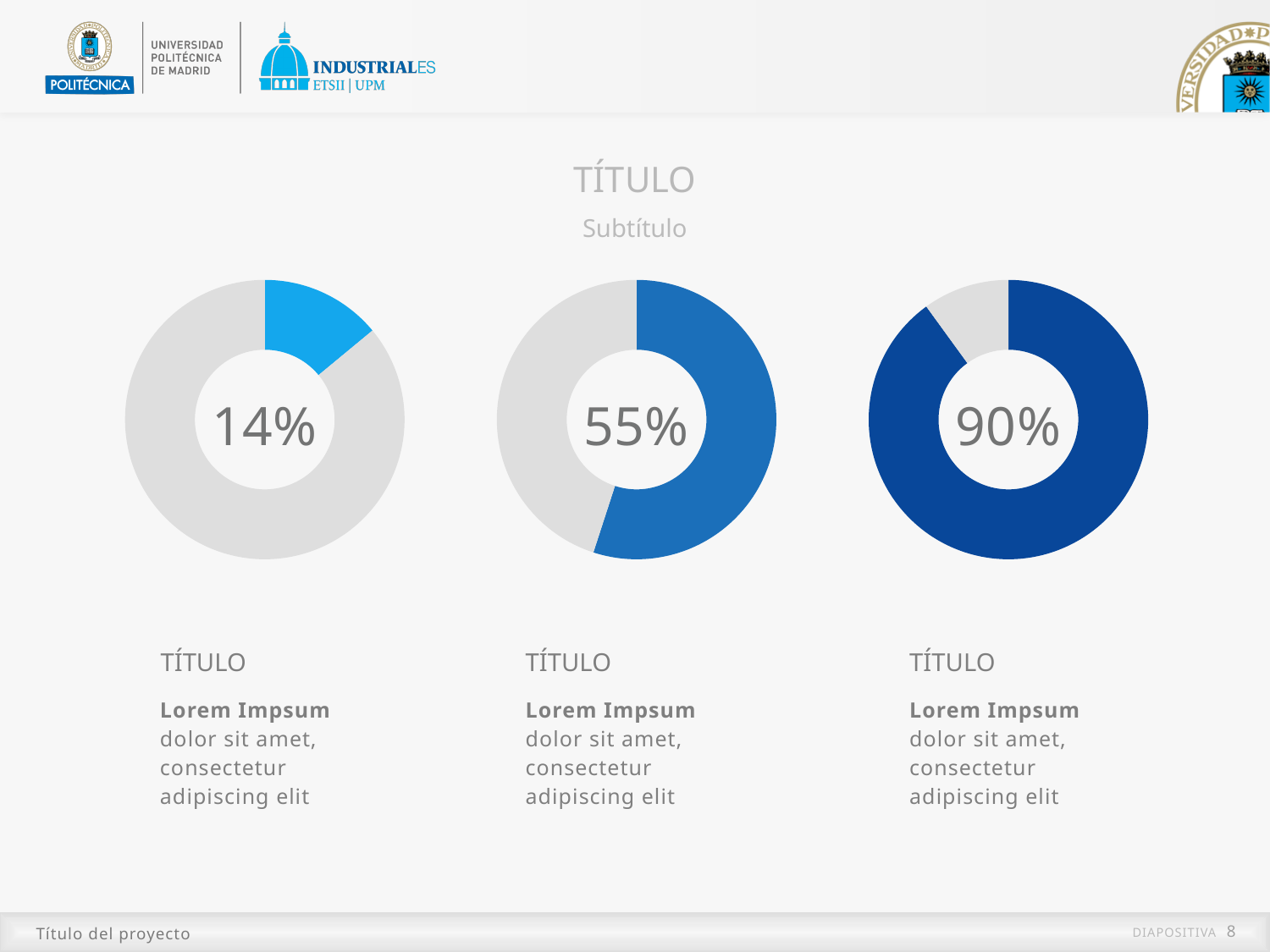
What kind of chart is used three times on this slide? Donut (pie) chart Is the percentage in the middle donut chart larger or smaller than the percentage in the right donut chart? Smaller Which of the three donut charts shows the lowest percentage? The left chart (14%) How many donut charts are shown on the slide? 3 What is the difference between the percentage in the middle donut chart and the percentage in the left donut chart? 41% What percentage is shown in the centre of the middle donut chart? 55% What percentage is shown in the centre of the left donut chart? 14% Which of the three donut charts shows the highest percentage? The right chart (90%) Which donut chart uses the lightest blue colour for its filled segment? The left chart (14%) In the right donut chart, what share of the ring is filled with the dark blue colour? 90% What percentage is shown in the centre of the right donut chart? 90% What is the difference between the percentage in the right donut chart and the percentage in the left donut chart? 76%